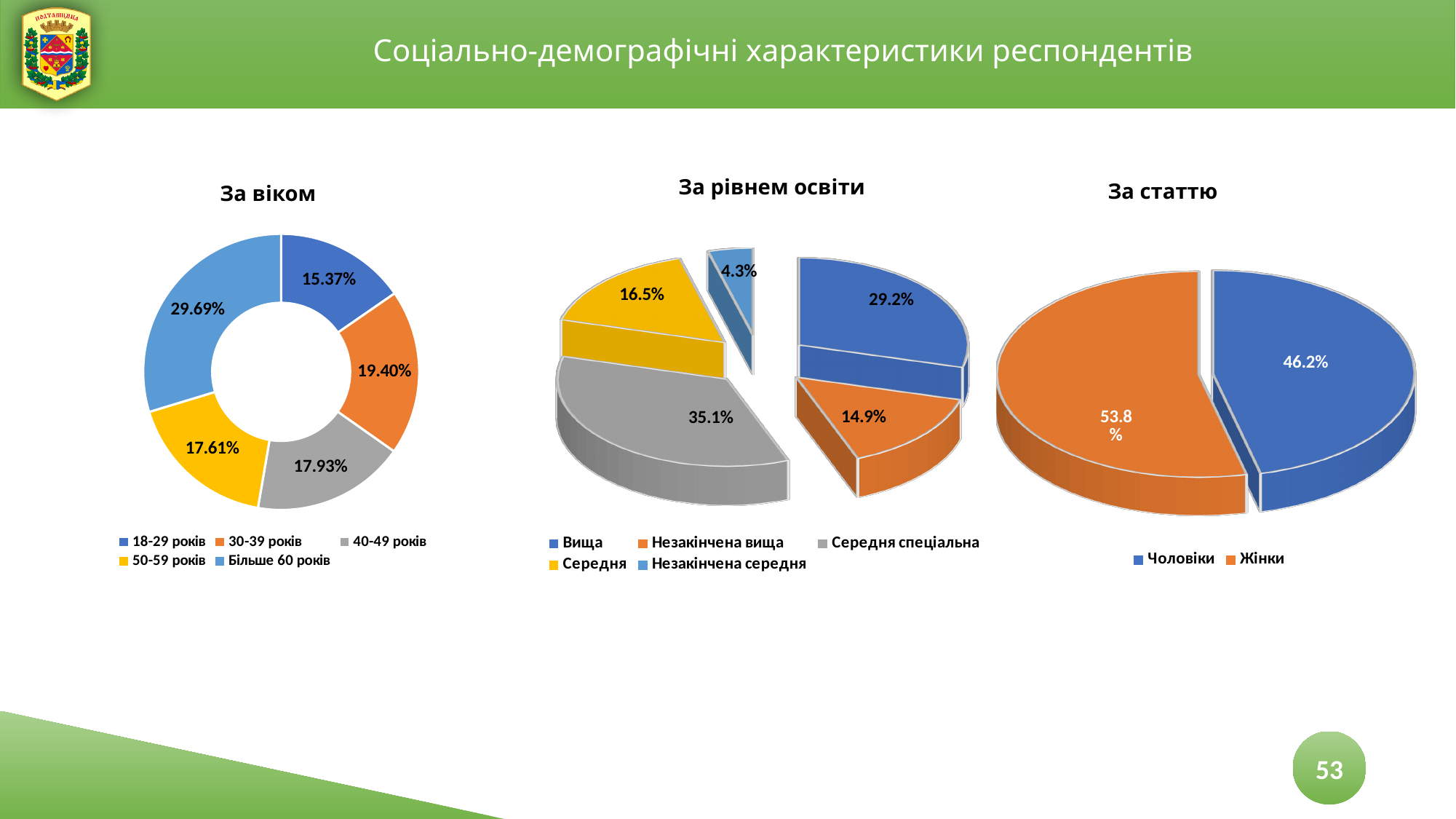
In the 'За рівнем освіти' chart, which is larger: 'Вища' or 'Незакінчена вища'? Вища In the 'За рівнем освіти' chart, what is the difference between 'Середня спеціальна' and 'Вища'? 5.9% In the 'За віком' chart, how many categories are shown? 5 In the 'За статтю' chart, what is the value for 'Жінки'? 53.8% In the 'За віком' chart, what colour is the '50-59 років' segment? Yellow In the 'За віком' chart, which category has the lowest share? 18-29 років In the 'За статтю' chart, which category has the larger share? Жінки In the 'За рівнем освіти' chart, what is the value for 'Середня спеціальна'? 35.1% In the 'За віком' chart, what is the value for 'Більше 60 років'? 29.69% In the 'За віком' chart, what is the difference between the '30-39 років' and '40-49 років' shares? 1.47% What kind of chart is the 'За статтю' chart? Pie chart In the 'За рівнем освіти' chart, which category has the smallest share? Незакінчена середня